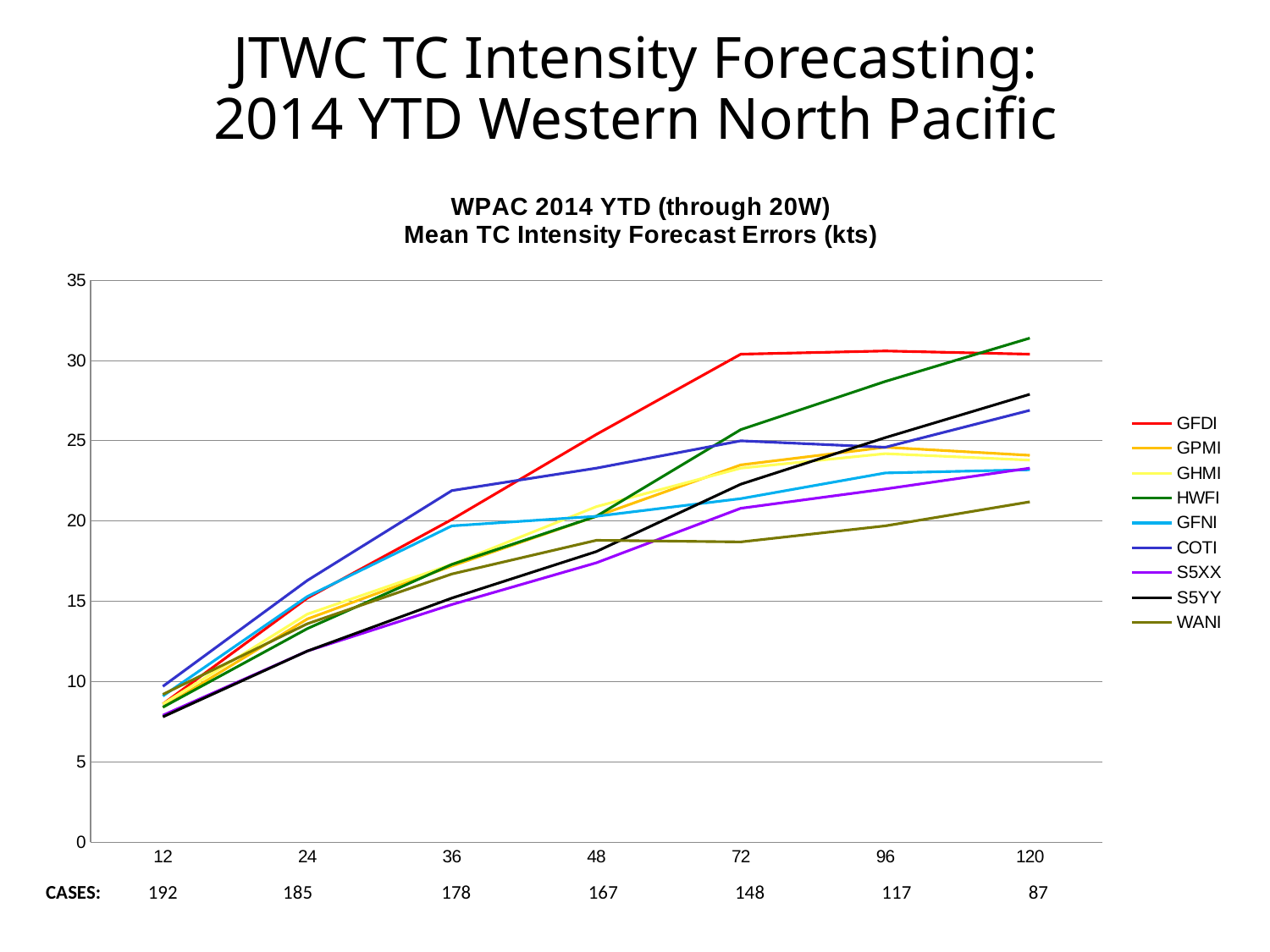
What kind of chart is shown on the slide? line chart Does the GFDI error rise or fall from 12 hours to 72 hours? rise Is the value for HWFI at 120 hours greater or less than 30? greater Is the value for COTI at 36 hours greater or less than 20? greater How many forecast hour categories are shown on the x axis? 7 Which series has the highest mean intensity forecast error at 120 hours? HWFI Is the value for S5XX at 48 hours greater or less than 20? less Which series has the lowest mean intensity forecast error at 120 hours? WANI How many series does the legend list? 9 How many cases are listed for the 120-hour forecast? 87 At 72 hours, which has the larger error, GFDI or WANI? GFDI Which series has the highest mean intensity forecast error at 72 hours? GFDI